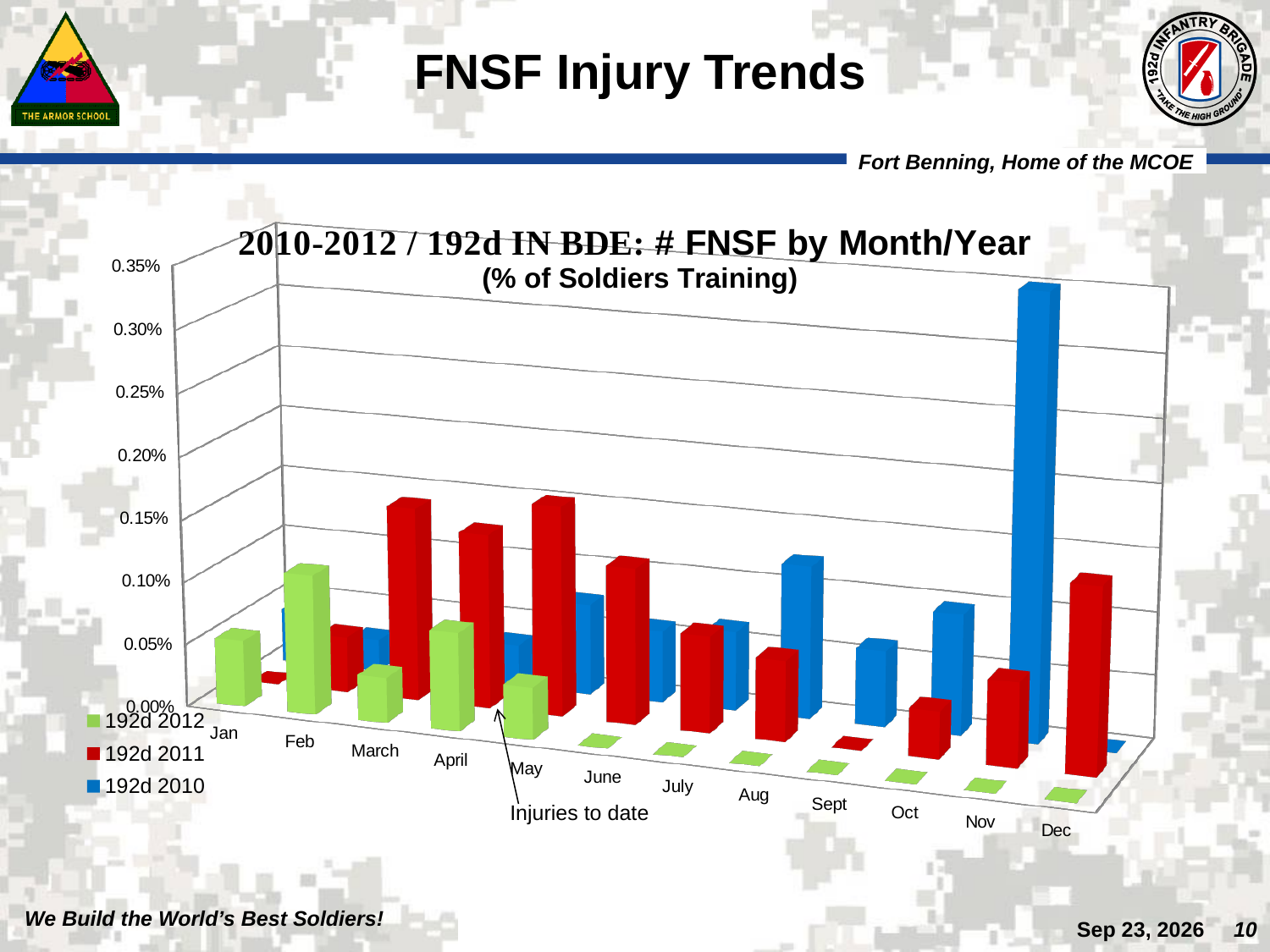
Which is larger, the 192d 2011 value for Feb or the 192d 2011 value for March? March What is the subtitle shown under the chart title? (% of Soldiers Training) Is the value for 192d 2012 in Jan greater or less than 0.10%? less What kind of chart is shown on the slide? bar chart Which series does the blue colour represent in the chart? 192d 2010 Is the value for 192d 2011 in March greater or less than 0.10%? greater How many months are shown along the x axis of the chart? 12 How many series does the chart legend list? 3 In which month does the tallest bar in the chart occur? Nov Is the value for 192d 2010 in Nov greater or less than 0.20%? greater Which is larger, the 192d 2012 value for Jan or the 192d 2012 value for Feb? Feb Which series has the single tallest bar in the chart? 192d 2010